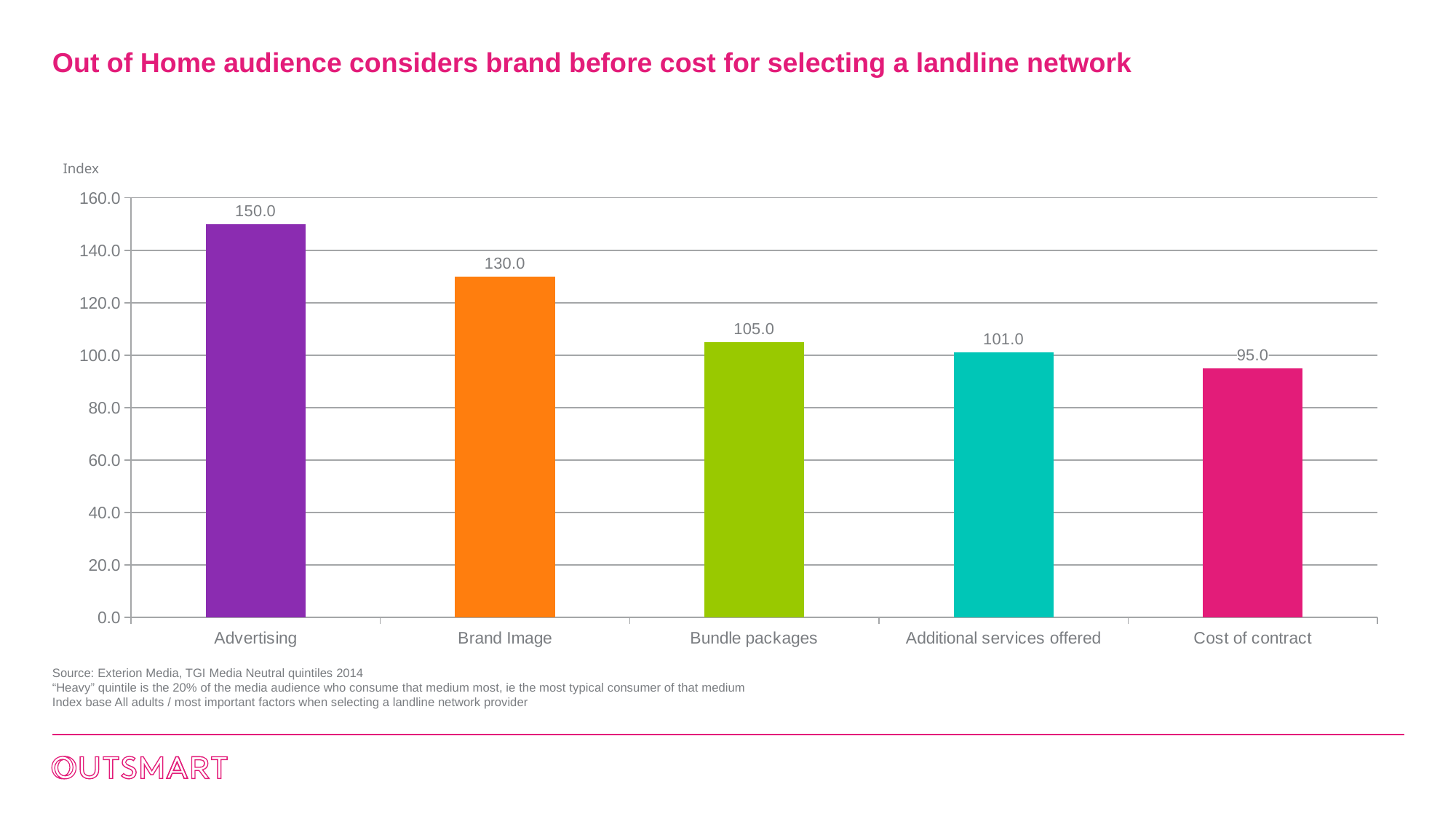
Which category has the lowest index value? Cost of contract What is the index value for Brand Image? 130.0 Which category has the highest index value? Advertising Which has a higher index value, Bundle packages or Cost of contract? Bundle packages What is the index value for Advertising? 150.0 What is the difference between the index values for Advertising and Brand Image? 20.0 Is the value for Bundle packages greater or less than 100? greater What is the index value for Cost of contract? 95.0 What is the index value for Additional services offered? 101.0 What kind of chart is shown on the slide? Bar chart How many categories are shown on the chart? 5 Do the index values rise or fall from left to right across the categories? Fall